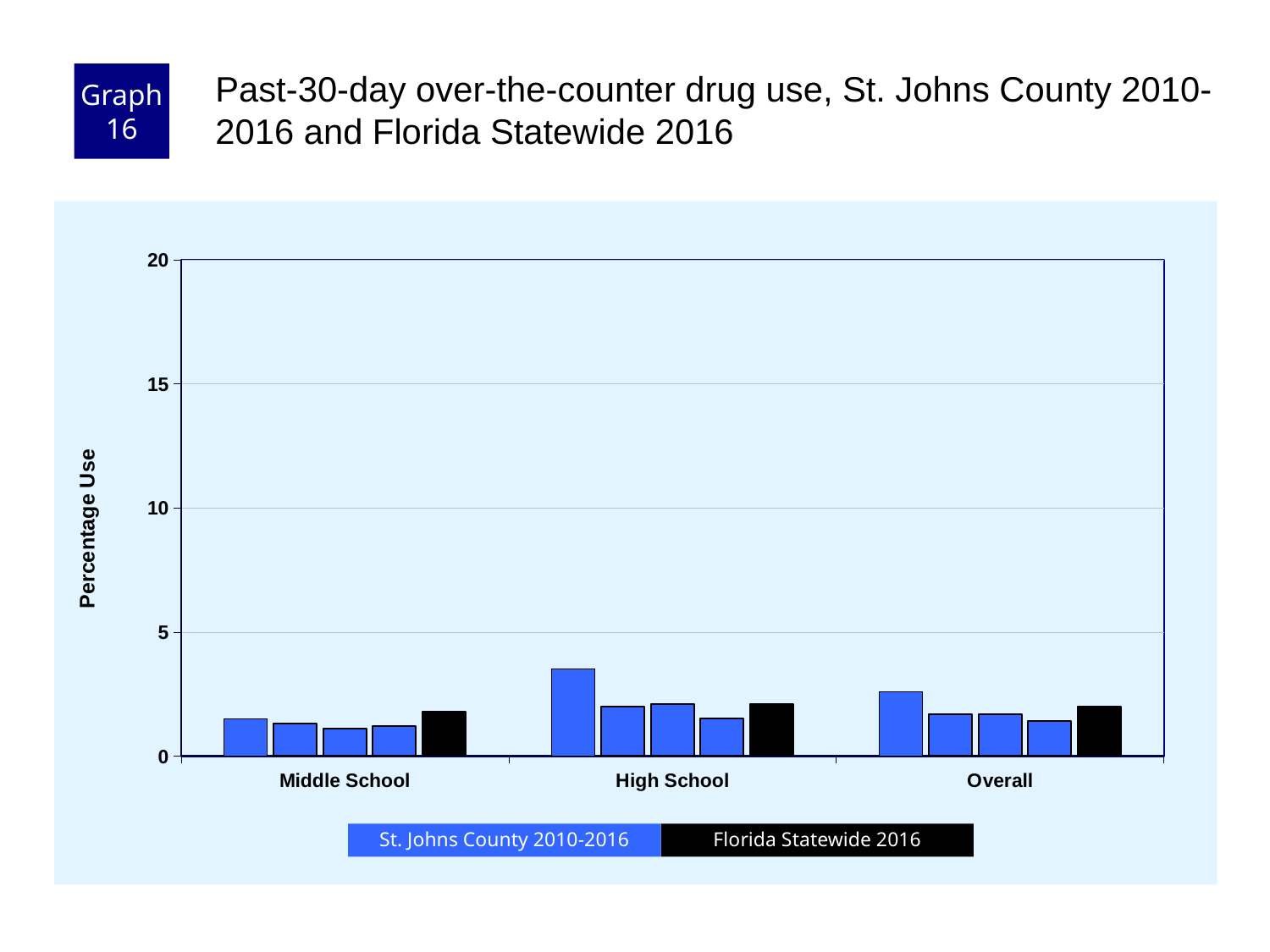
Is the Florida Statewide 2016 value for High School greater or less than 5? less Which category contains the tallest bar in the chart? High School How many series does the legend list? 2 What kind of chart is shown on the slide? bar chart How many categories are shown on the x axis? 3 Which is larger: the tallest St. Johns County bar for High School or the tallest St. Johns County bar for Middle School? High School What is the label on the y axis? Percentage Use Is the tallest St. Johns County bar for High School greater or less than 5? less Which is larger: the Florida Statewide 2016 bar for High School or the Florida Statewide 2016 bar for Middle School? High School Which series is shown in black? Florida Statewide 2016 Is any bar in the chart greater than 10? No